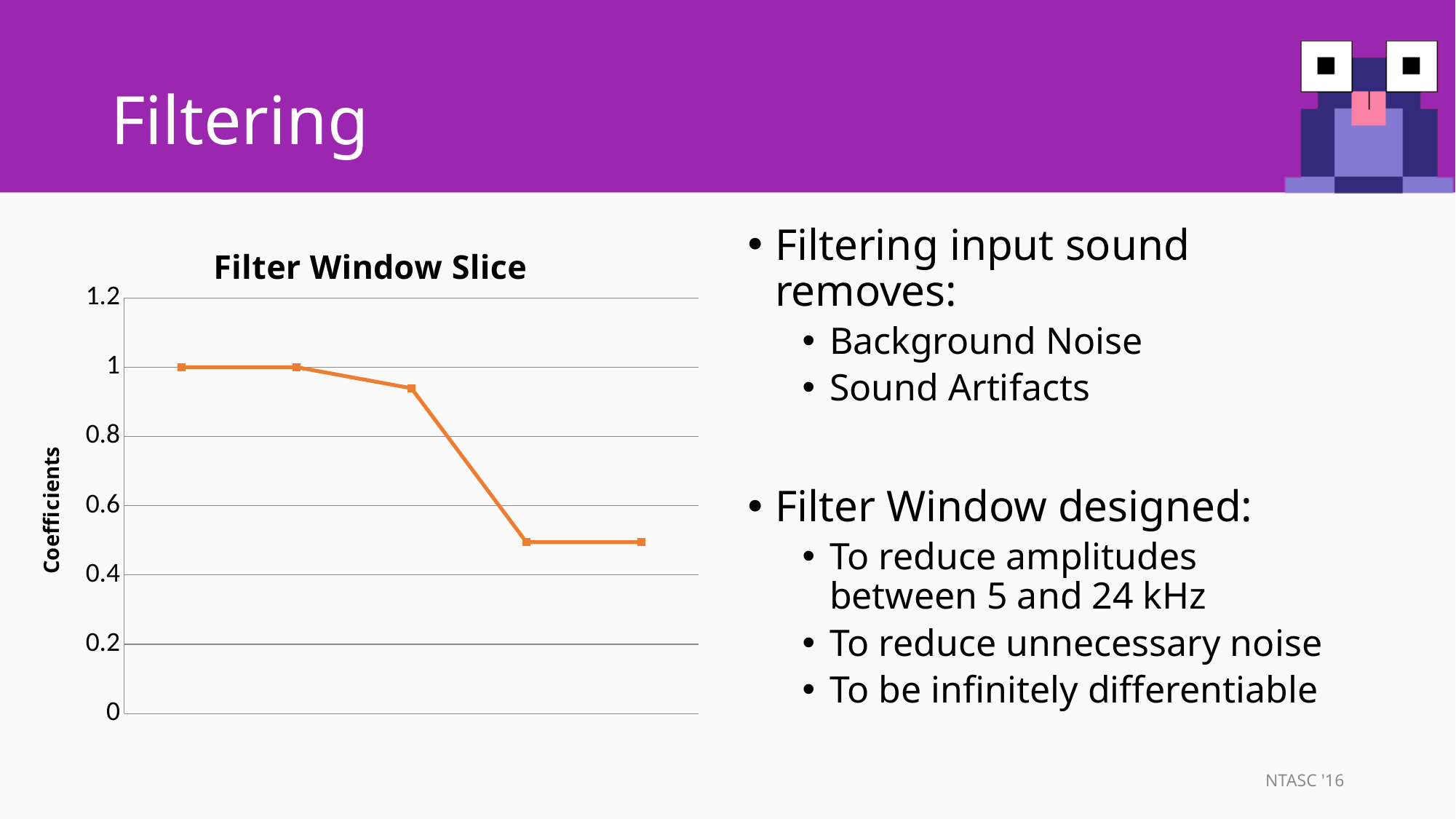
How many data points are plotted on the line? 5 What is the value of the first (leftmost) point on the line? 1 Which is larger, the value of the first point or the value of the last point? the first point What is the label of the vertical axis? Coefficients What kind of chart is shown on the slide? line chart Do the values rise or fall from left to right along the line? fall Is the value of the third point greater or less than 0.8? greater Is the value of the fourth point greater or less than 0.6? less What is the highest value shown on the vertical axis? 1.2 What is the title of the chart? Filter Window Slice Is the value of the last (rightmost) point greater or less than 0.4? greater What is the value of the second point on the line? 1